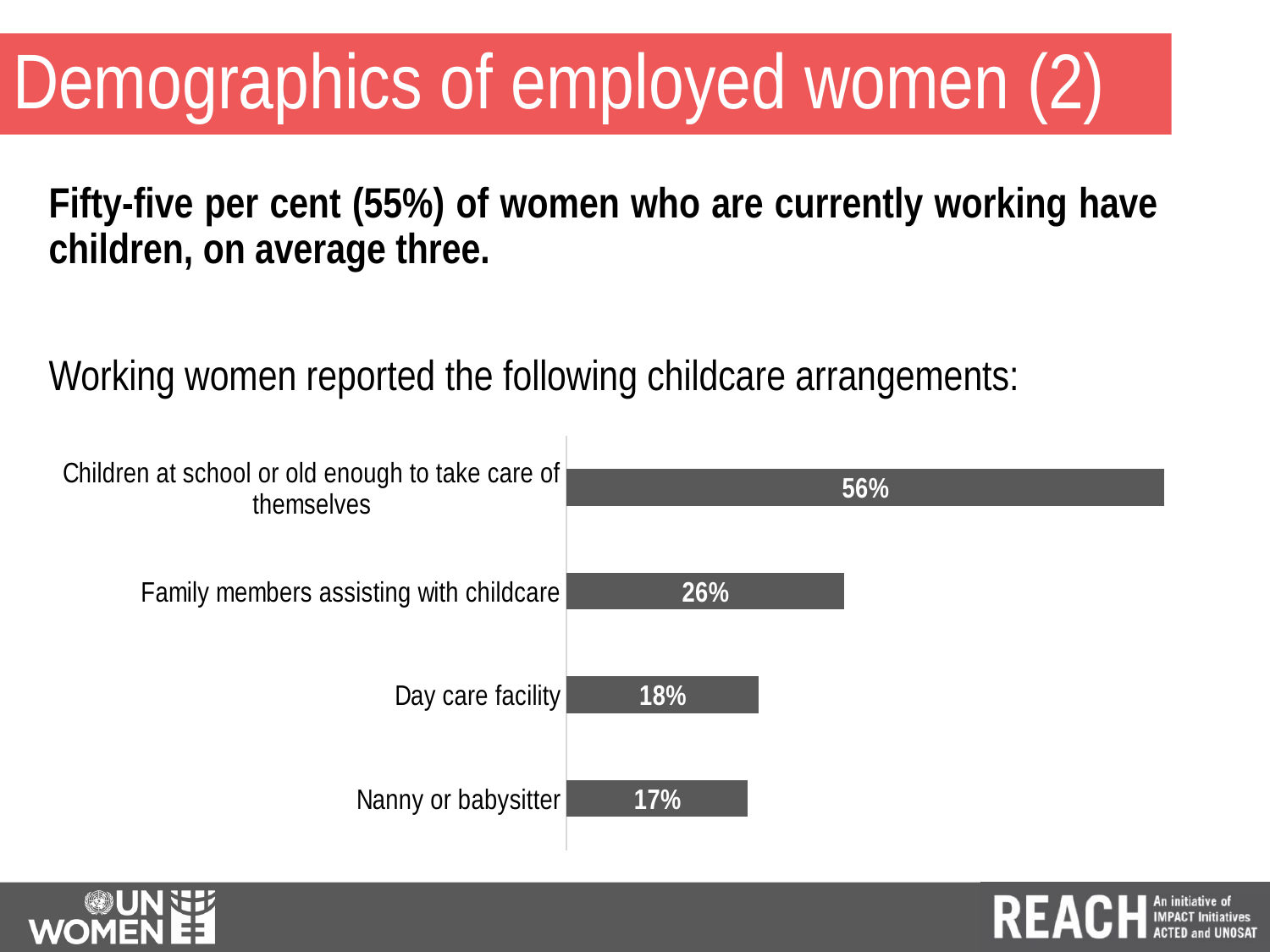
What type of chart is used to show the childcare arrangements? Bar chart Which childcare arrangement has the lowest percentage? Nanny or babysitter What percentage is shown for 'Nanny or babysitter'? 17% Which childcare arrangement has the highest percentage? Children at school or old enough to take care of themselves What is the value for 'Children at school or old enough to take care of themselves'? 56% How many childcare arrangement categories are shown in the chart? 4 What is the difference in percentage points between 'Children at school or old enough to take care of themselves' and 'Family members assisting with childcare'? 30 percentage points What is the difference between 'Day care facility' and 'Nanny or babysitter'? 1 percentage point What is the value shown for 'Day care facility'? 18% What percentage of working women reported 'Family members assisting with childcare'? 26% What colour are the bars in the chart? Dark grey Which is larger: the value for 'Family members assisting with childcare' or 'Day care facility'? Family members assisting with childcare